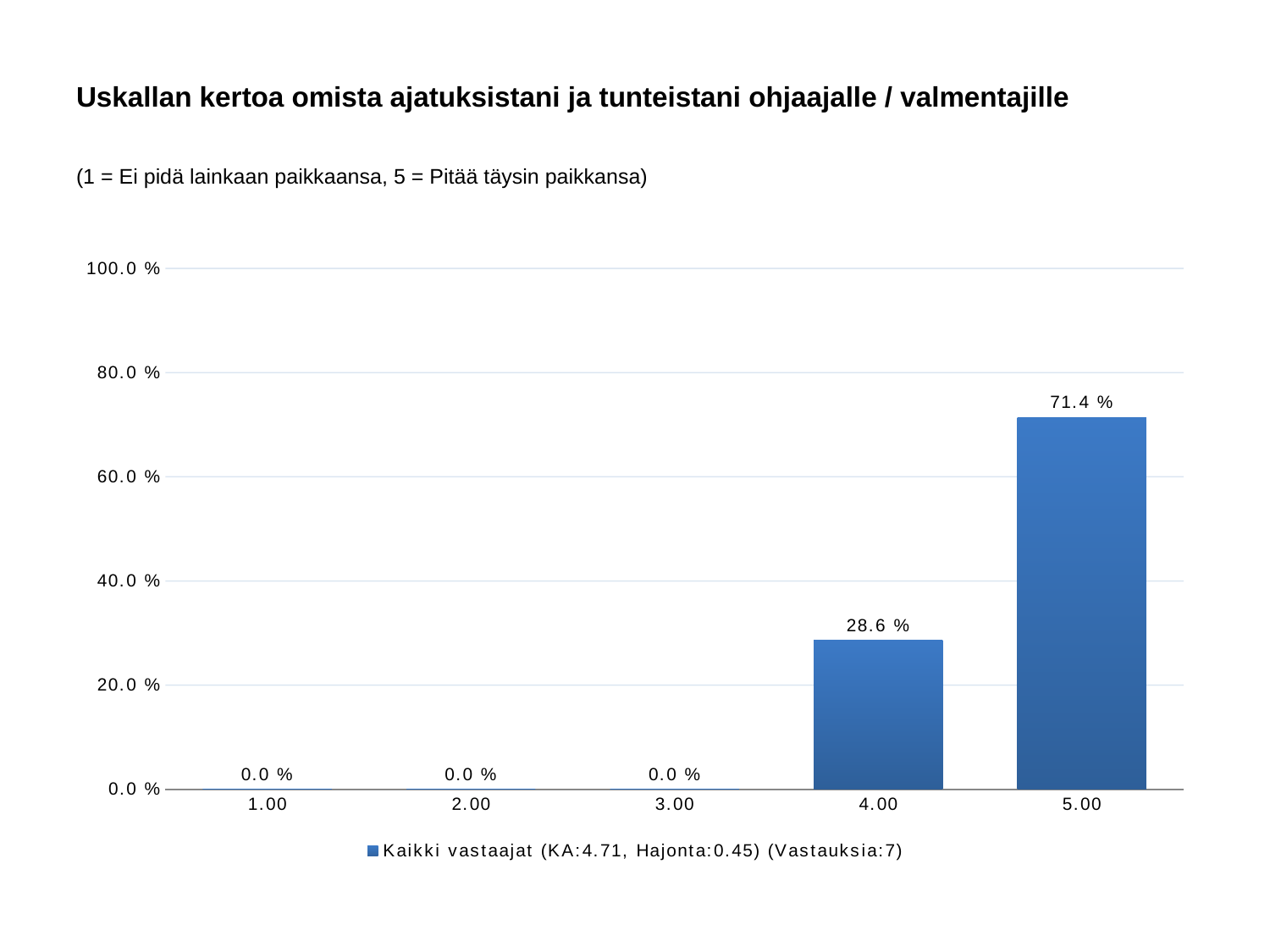
What is the difference between the values for 5.00 and 4.00? 42.8 % How many categories are shown on the x axis? 5 Is the value for 5.00 greater or less than 60.0 %? greater What is the value for category 5.00? 71.4 % Which is larger, the value for 4.00 or the value for 5.00? 5.00 What kind of chart is shown? bar chart What is the value for category 1.00? 0.0 % How many series does the legend list? 1 What is the legend entry for the series? Kaikki vastaajat (KA:4.71, Hajonta:0.45) (Vastauksia:7) Which category has the highest value? 5.00 Is the value for 4.00 greater or less than 40.0 %? less What is the value for category 4.00? 28.6 %